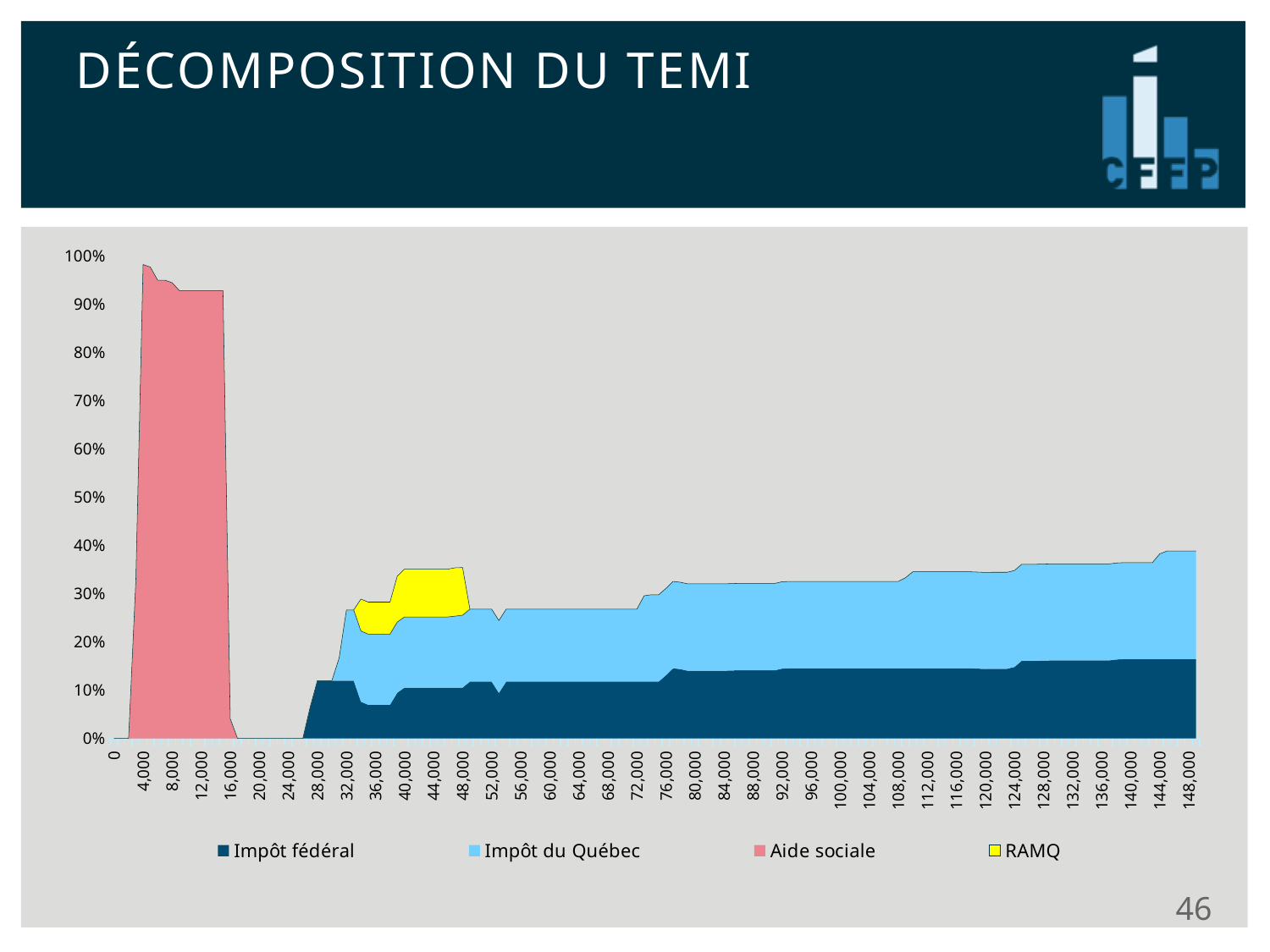
What is the title of the slide containing the chart? DÉCOMPOSITION DU TEMI Which series is shown in yellow in the chart? RAMQ What kind of chart is shown on the slide? Stacked area chart Is the value for Impôt fédéral at 100,000 greater or less than 10%? greater Is the value for Aide sociale at 8,000 greater or less than 90%? greater Is the total stacked value at 148,000 greater or less than 30%? greater How many series does the legend list? 4 Does the total stacked value rise or fall along the x axis from 80,000 to 148,000? rise Which is larger at 8,000: the value for Aide sociale or the value for Impôt fédéral? Aide sociale Which series reaches the highest value anywhere on the chart? Aide sociale